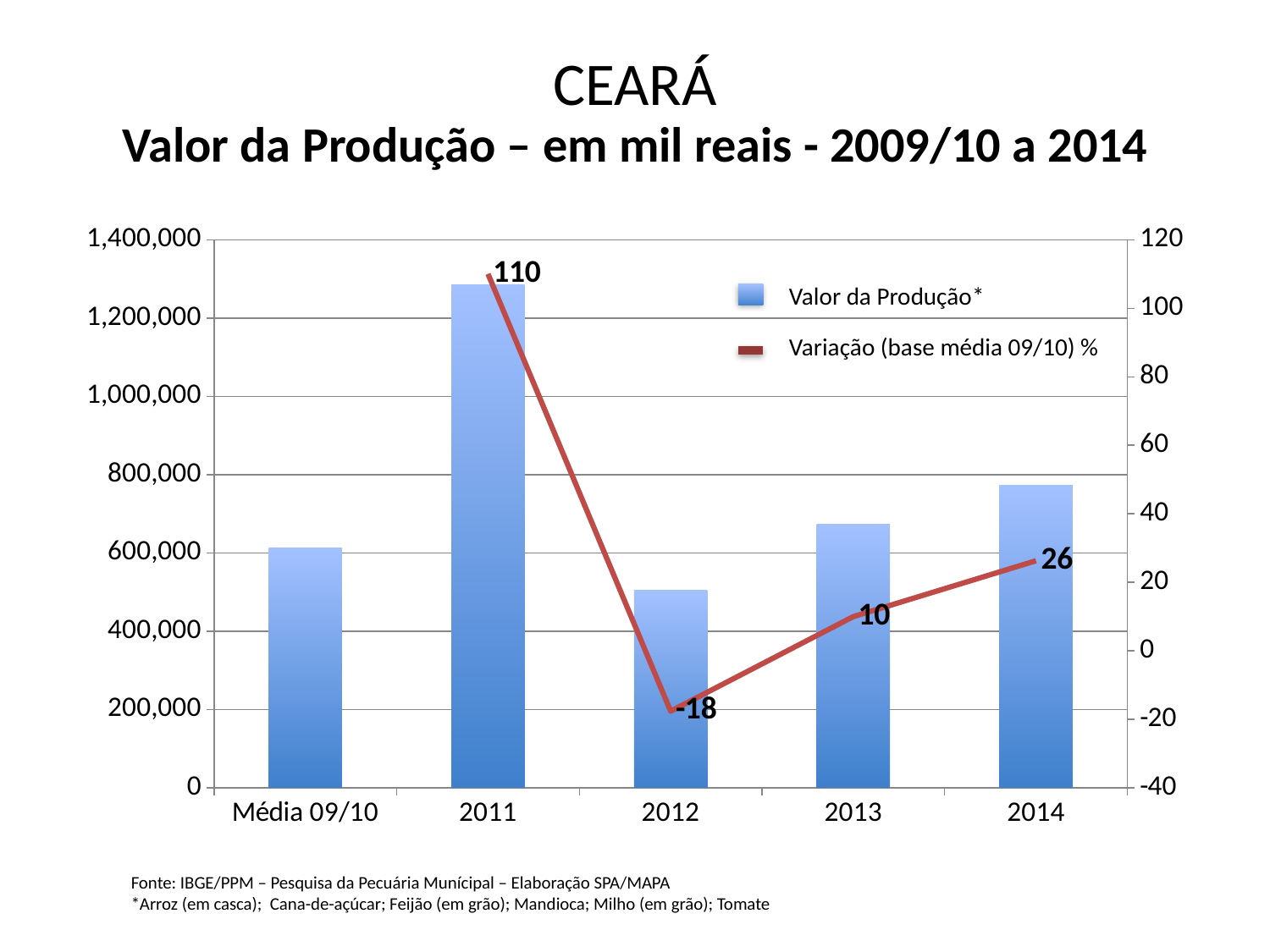
Which is larger, the Valor da Produção for 2013 or for 2014? 2014 What is the Variação (base média 09/10) % value for 2011? 110 What is the difference between the Variação values for 2014 and 2013? 16 How many series does the legend list? 2 What is the Variação (base média 09/10) % value for 2014? 26 Which year has the highest Valor da Produção bar? 2011 How many categories are shown on the x axis? 5 Is the Valor da Produção for 2011 greater or less than 1,200,000? greater Which category has the lowest Valor da Produção bar? 2012 What is the Variação (base média 09/10) % value for 2012? -18 What kind of chart is this? Combination bar and line chart Is the Valor da Produção for 2012 greater or less than 600,000? less